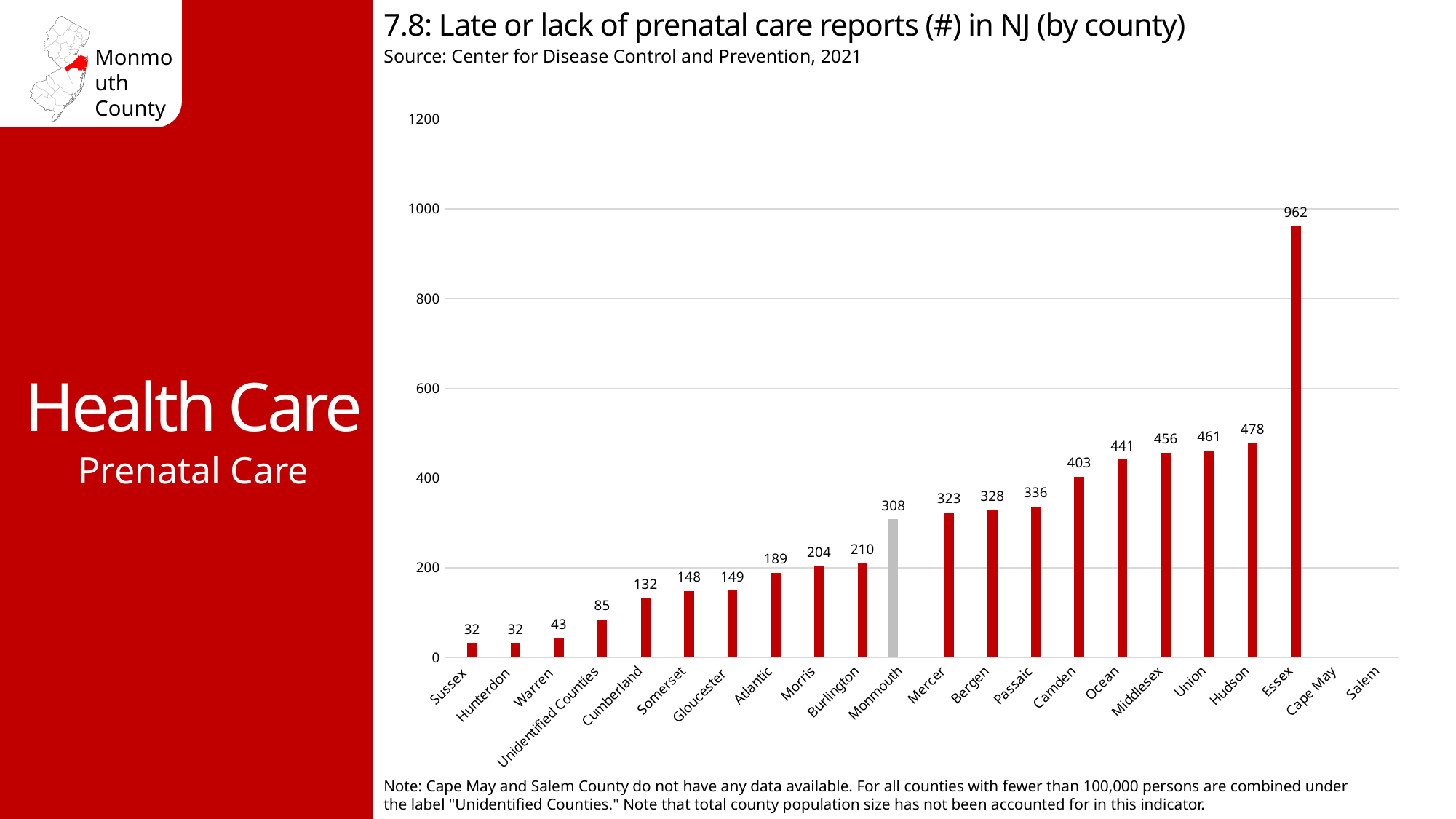
What is the value for Essex? 962 Is the value for Burlington greater or less than 400? less Which is larger, the value for Camden or the value for Ocean? Ocean Which county's bar is coloured grey instead of red? Monmouth What is the value for Unidentified Counties? 85 What is the value for Monmouth? 308 What is the difference between the values for Essex and Hudson? 484 What is the difference between the values for Monmouth and Mercer? 15 Do the values generally rise or fall from Sussex to Essex along the x axis? rise Which county has the highest number of late or lack of prenatal care reports? Essex How many categories are labelled on the x axis? 22 What kind of chart is shown on the slide? bar chart